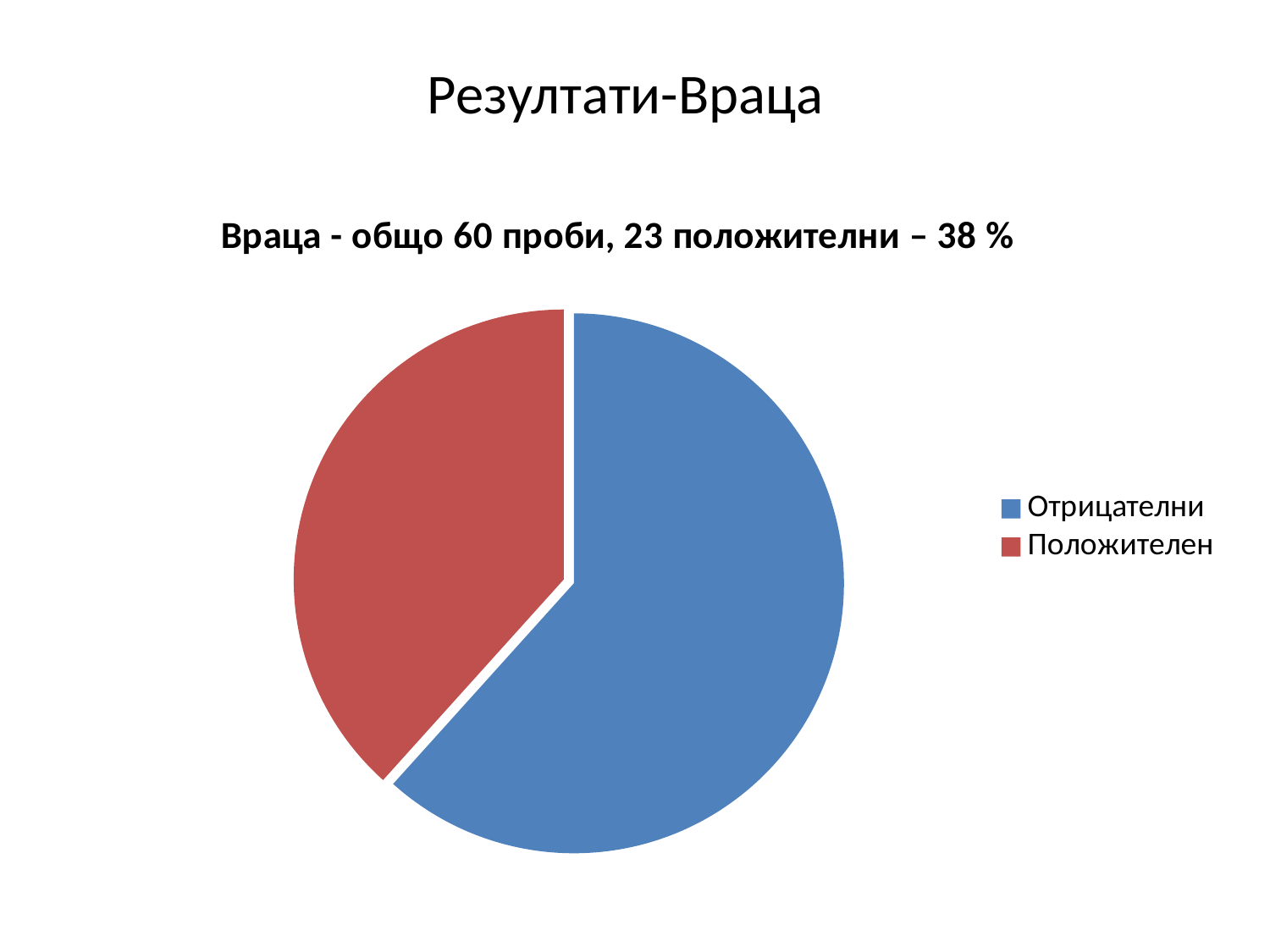
Which slice of the pie chart is the largest? Отрицателни How many entries does the legend of the pie chart list? 2 Which slice is larger, Отрицателни or Положителен? Отрицателни What colour is the Положителен slice in the pie chart? red How many positive samples does the chart title report for Враца? 23 What share of the samples is Положителен, according to the chart title? 38 % What kind of chart is shown on the slide? pie chart How many samples in total does the chart title report for Враца? 60 Which slice of the pie chart is the smallest? Положителен How many slices does the pie chart have? 2 What is the title of the pie chart? Враца - общо 60 проби, 23 положителни – 38 %